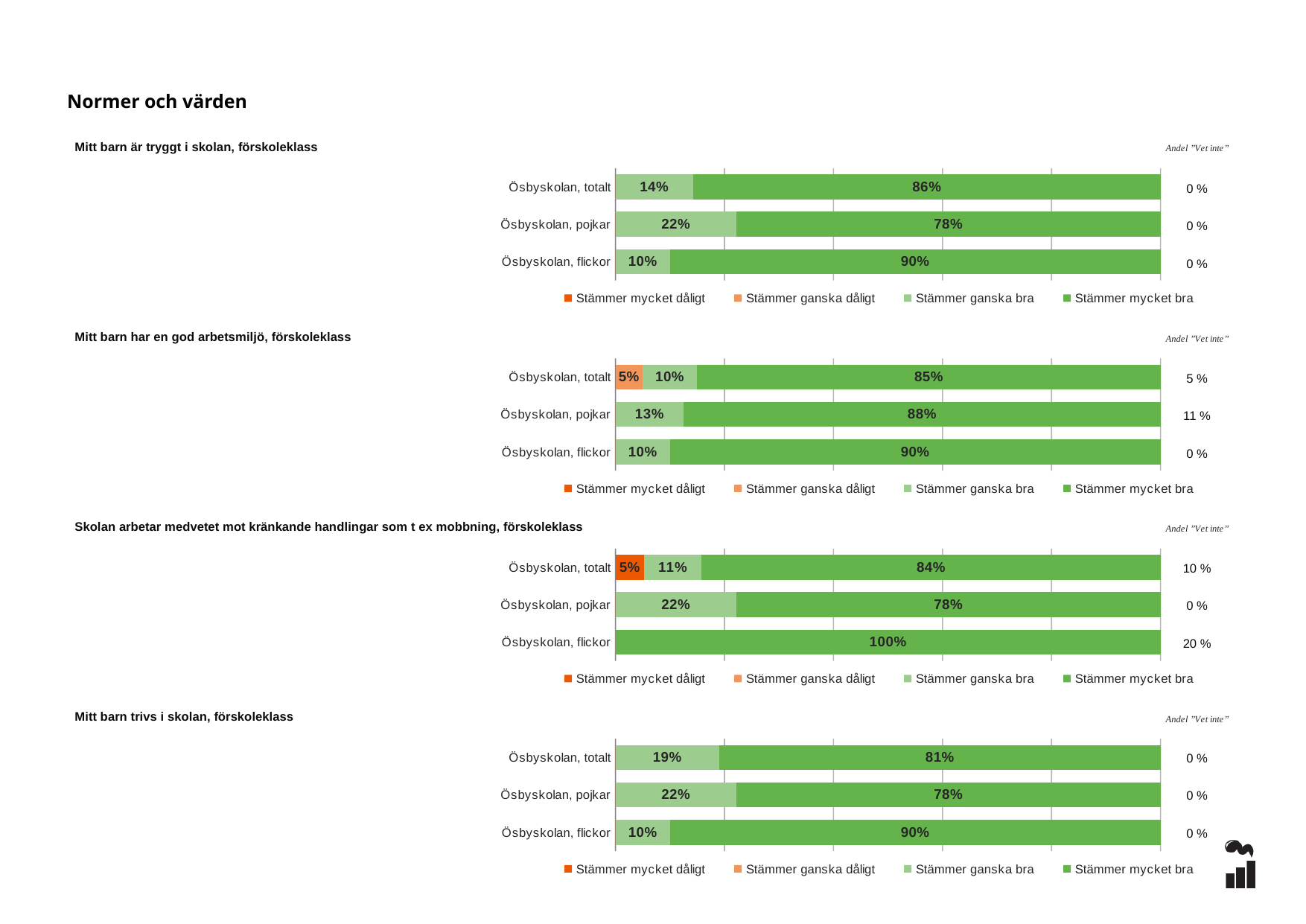
In the chart 'Mitt barn är tryggt i skolan, förskoleklass', which is larger: the 'Stämmer ganska bra' value for Ösbyskolan, pojkar or for Ösbyskolan, flickor? Ösbyskolan, pojkar In the chart 'Mitt barn är tryggt i skolan, förskoleklass', which category has the highest 'Stämmer mycket bra' value? Ösbyskolan, flickor In the chart 'Mitt barn trivs i skolan, förskoleklass', what is the difference between the 'Stämmer mycket bra' values for Ösbyskolan, flickor and Ösbyskolan, pojkar? 12% In the chart 'Mitt barn trivs i skolan, förskoleklass', what is the 'Stämmer ganska bra' value for Ösbyskolan, totalt? 19% How many series does the legend list in the chart 'Mitt barn trivs i skolan, förskoleklass'? 4 What kind of chart is 'Mitt barn är tryggt i skolan, förskoleklass'? Stacked bar chart In the chart 'Mitt barn är tryggt i skolan, förskoleklass', what is the 'Stämmer mycket bra' value for Ösbyskolan, pojkar? 78% How many categories are shown in the chart 'Mitt barn har en god arbetsmiljö, förskoleklass'? 3 In the chart 'Mitt barn har en god arbetsmiljö, förskoleklass', what is the 'Stämmer ganska bra' value for Ösbyskolan, pojkar? 13% In the chart 'Skolan arbetar medvetet mot kränkande handlingar som t ex mobbning, förskoleklass', what is the 'Stämmer mycket dåligt' value for Ösbyskolan, totalt? 5% In the chart 'Skolan arbetar medvetet mot kränkande handlingar som t ex mobbning, förskoleklass', what is the 'Stämmer mycket bra' value for Ösbyskolan, flickor? 100% In the chart 'Mitt barn har en god arbetsmiljö, förskoleklass', what is the 'Stämmer ganska dåligt' value for Ösbyskolan, totalt? 5%